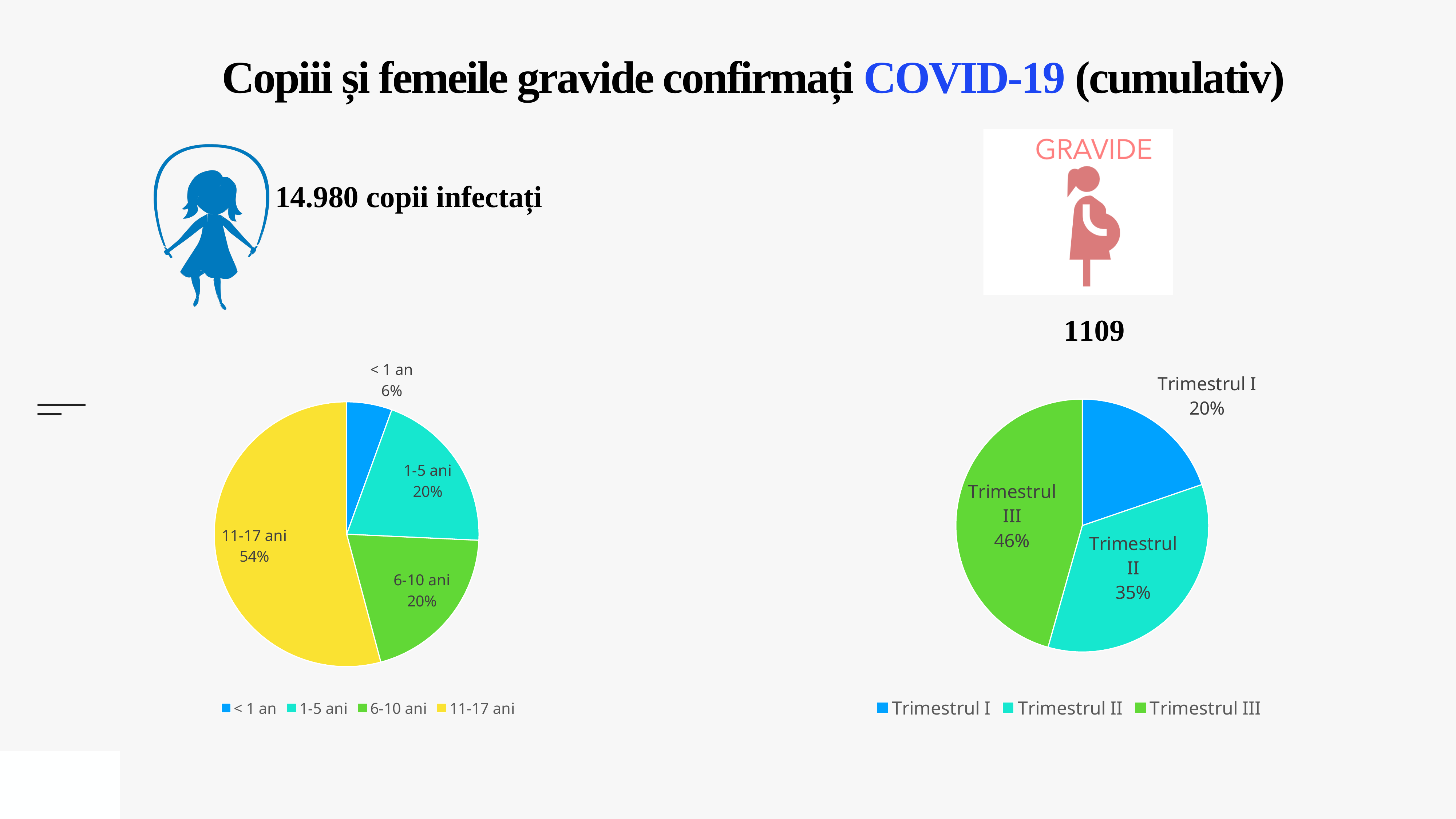
In the right pie chart (pregnant women by trimester), which is larger, Trimestrul I or Trimestrul II? Trimestrul II In the right pie chart (pregnant women by trimester), which trimester has the largest share? Trimestrul III In the left pie chart (children by age group), what is the difference in percentage points between the 11-17 ani slice and the 6-10 ani slice? 34 In the left pie chart (children by age group), what share is labelled for the 11-17 ani slice? 54% In the right pie chart (pregnant women by trimester), how many entries does the legend list? 3 In the left pie chart (children by age group), which age group has the largest share? 11-17 ani What kind of chart is the right chart (pregnant women by trimester)? Pie chart In the right pie chart (pregnant women by trimester), what share is labelled for Trimestrul II? 35% In the left pie chart (children by age group), how many slices are there? 4 In the left pie chart (children by age group), which age group has the smallest share? < 1 an In the left pie chart (children by age group), what share is labelled for the < 1 an slice? 6% In the right pie chart (pregnant women by trimester), what is the difference in percentage points between Trimestrul III and Trimestrul I? 26